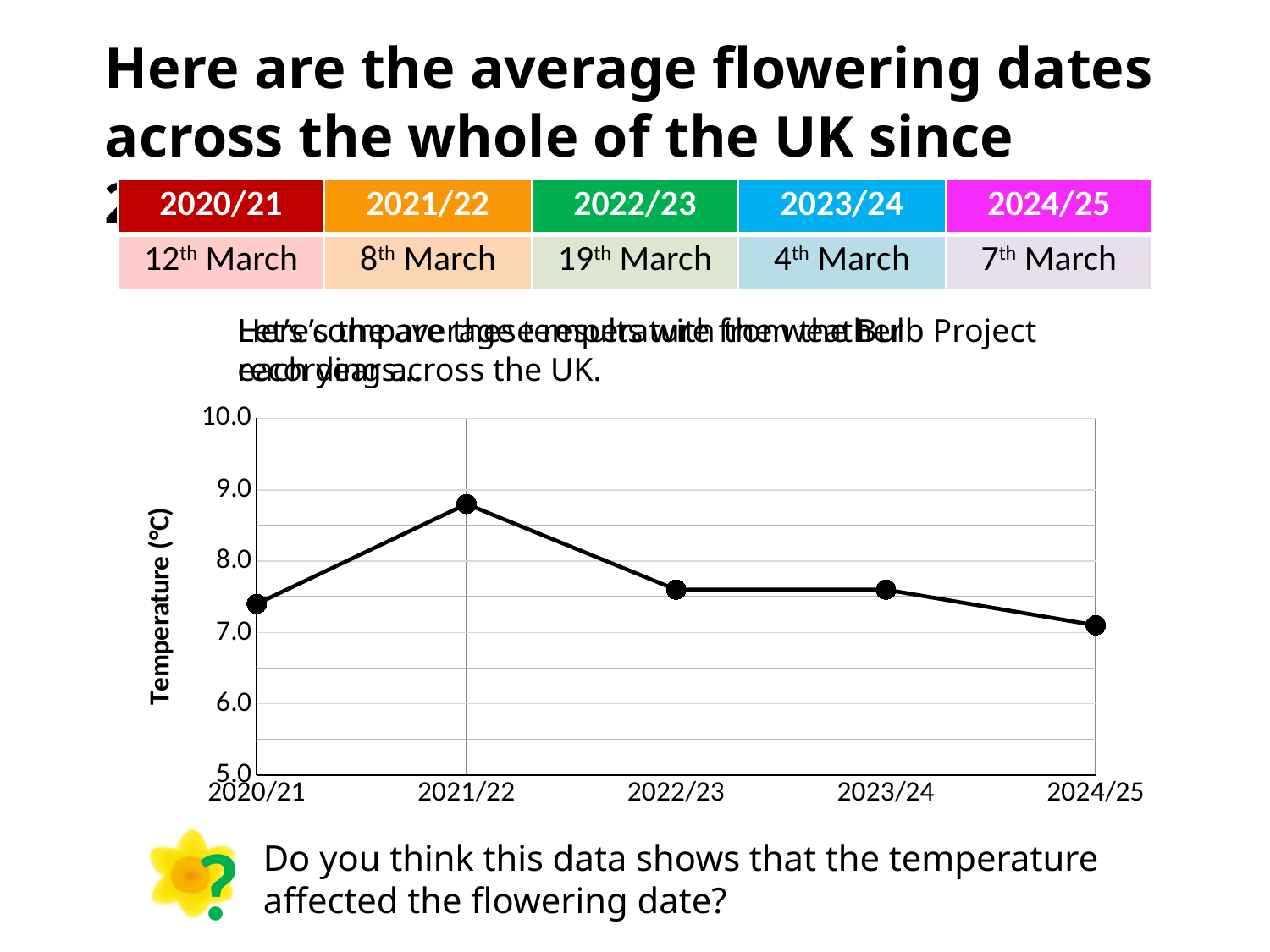
What kind of chart is shown on the slide? line chart Which year has the lowest temperature on the chart? 2024/25 Is the temperature for 2022/23 greater or less than 8.0? less What is the label on the vertical axis of the chart? Temperature (°C) Which has the higher temperature, 2020/21 or 2021/22? 2021/22 Is the temperature for 2020/21 greater or less than 7.0? greater How many data points are plotted on the temperature chart? 5 Which has the higher temperature, 2021/22 or 2022/23? 2021/22 Is the temperature for 2021/22 greater or less than 8.0? greater Does the temperature rise or fall from 2021/22 to 2024/25? fall Which year has the highest temperature on the chart? 2021/22